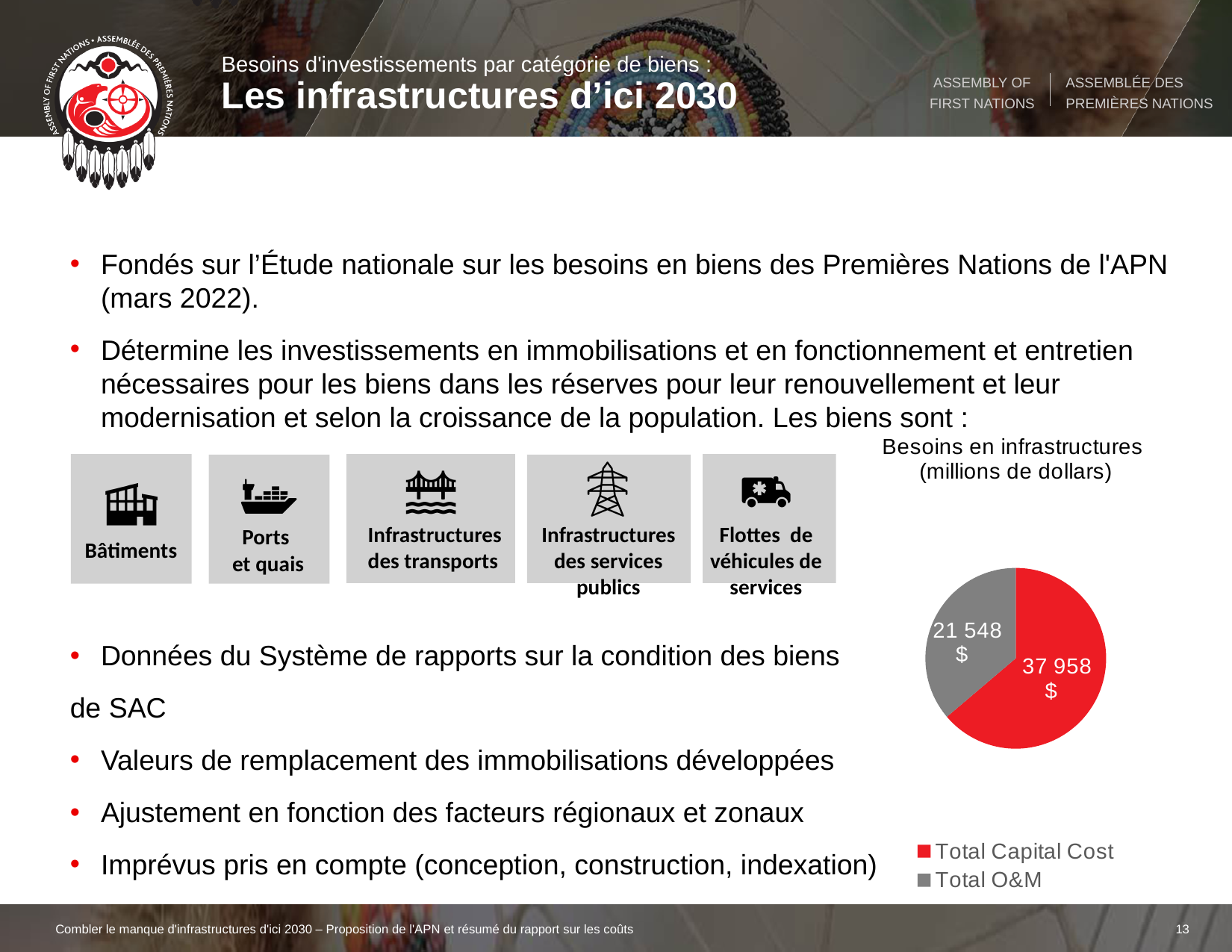
Which slice is the largest? Total Capital Cost How many entries does the legend list? 2 What is the value for Total O&M? 21 548 $ Which is larger, Total Capital Cost or Total O&M? Total Capital Cost What colour is the Total O&M slice? grey What is the title of the chart? Besoins en infrastructures (millions de dollars) What is the total of the two slices in the pie chart? 59 506 $ What is the difference between Total Capital Cost and Total O&M? 16 410 $ Which slice is the smallest? Total O&M How many slices does the pie chart have? 2 What kind of chart is shown on the slide? pie chart What is the value for Total Capital Cost? 37 958 $